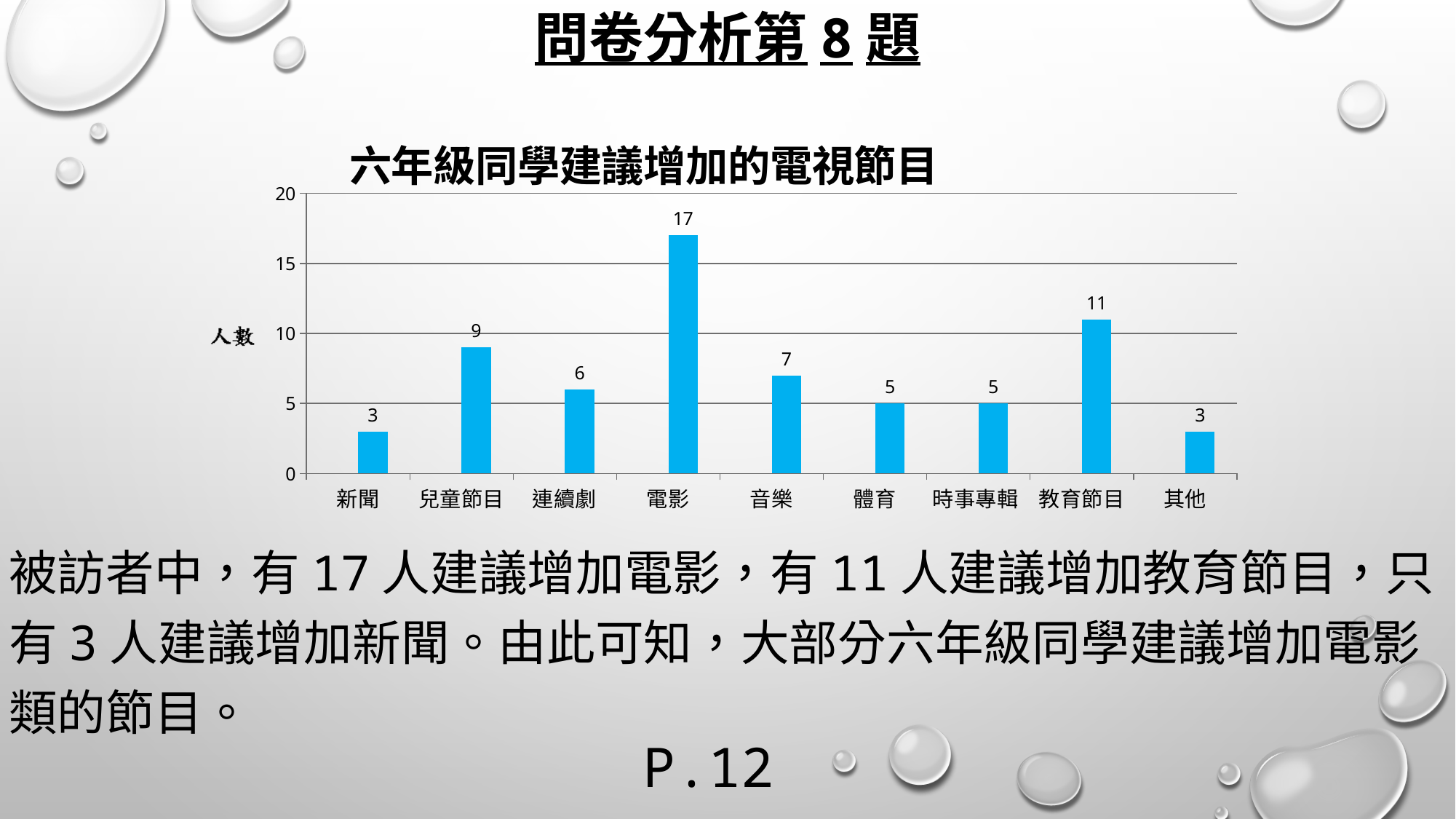
Which is larger, the value for 兒童節目 or the value for 音樂? 兒童節目 What is the label on the vertical axis? 人數 How many categories are shown on the x axis? 9 Is the value for 教育節目 greater or less than 10? greater What is the difference between the values for 電影 and 教育節目? 6 What kind of chart is shown on the slide? bar chart What is the value for 兒童節目? 9 Which category has the highest value? 電影 What is the value for 教育節目? 11 Which category has the lowest value, 連續劇 or 音樂? 連續劇 What is the title of the chart? 六年級同學建議增加的電視節目 What is the value for 電影? 17